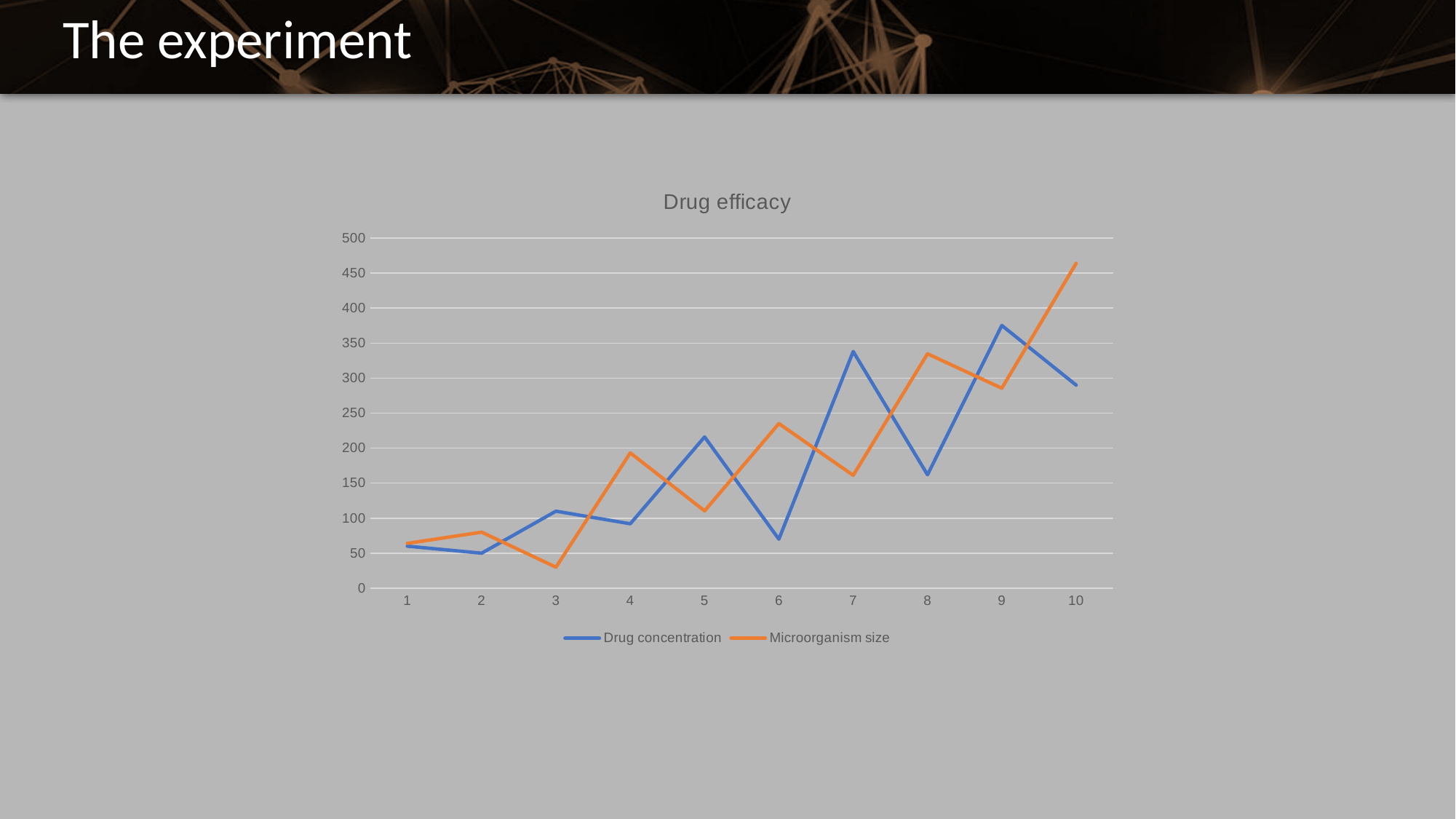
At which x-axis point does Microorganism size reach its highest value? 10 How many points are plotted along the x axis for each series? 10 At which x-axis point does Drug concentration reach its highest value? 9 Is the value for Drug concentration at point 7 greater or less than 300? greater How many series does the legend list? 2 At point 8, which series has the larger value, Drug concentration or Microorganism size? Microorganism size At point 5, which series has the larger value, Drug concentration or Microorganism size? Drug concentration What is the title of the chart? Drug efficacy What kind of chart is shown on the slide? line chart Is the value for Microorganism size at point 10 greater or less than 400? greater At which x-axis point does Microorganism size reach its lowest value? 3 Is the value for Drug concentration at point 6 greater or less than 100? less